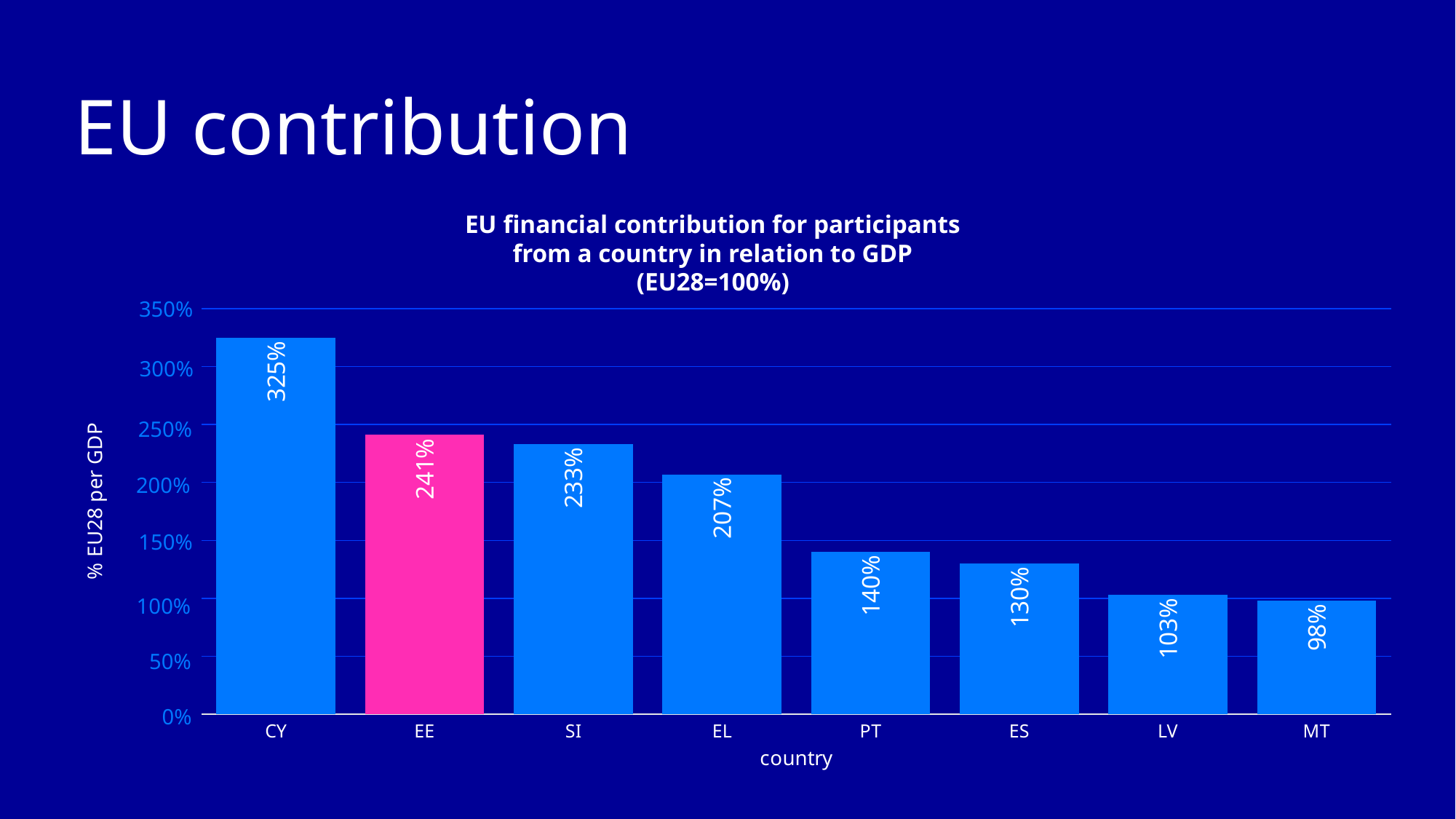
What is the difference between the values for EL and ES? 77% What is the value for PT? 140% What is the value for MT? 98% Which is larger, the value for SI or the value for EL? SI What kind of chart is shown? bar chart What is the value for EE? 241% Is the value for LV greater or less than 150%? less Which country has the lowest value? MT What is the difference between the values for CY and EE? 84% Which country's bar is coloured pink instead of blue? EE Which country has the highest value? CY How many countries are shown on the x axis? 8